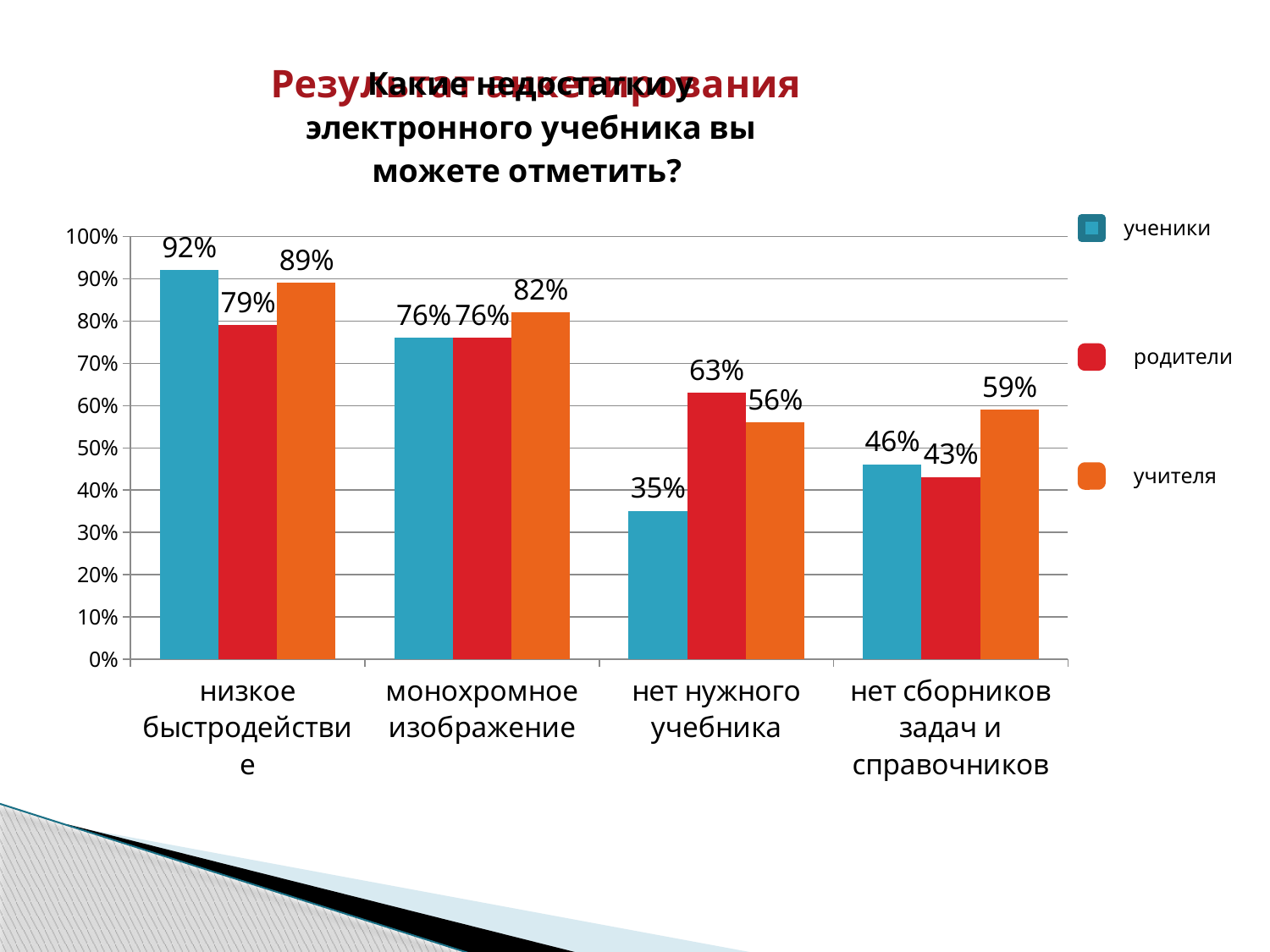
What kind of chart is shown on the slide? bar chart Which category has the highest value for учителя? низкое быстродействие How many series does the legend list? 3 What percentage of ученики noted низкое быстродействие? 92% Which category has the lowest value for ученики? нет нужного учебника Which series is shown in orange in the legend? учителя How many categories are shown on the x axis? 4 What is the difference between the родители and ученики values for нет нужного учебника? 28% What is the value for родители in the category нет нужного учебника? 63% What is the difference between the ученики and родители values for низкое быстродействие? 13% What is the value for учителя in the category нет сборников задач и справочников? 59% Which is larger for монохромное изображение: the value for учителя or the value for родители? учителя